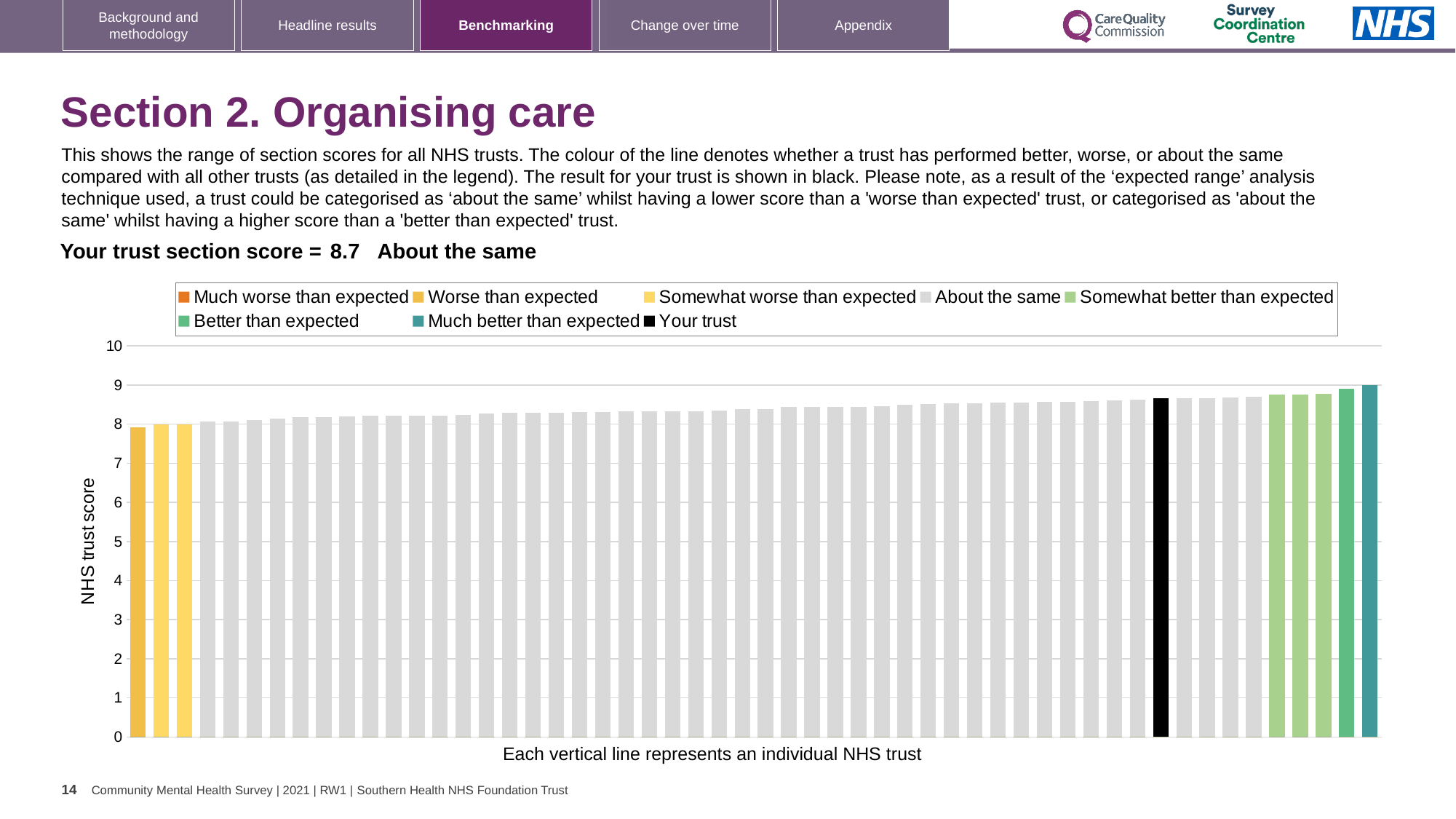
Is the value of the tallest bar greater or less than 10? less Which legend category does the tallest bar on the chart belong to? Much better than expected What is the section score for your trust shown on the slide? 8.7 How many entries does the chart legend list? 8 What is the label on the vertical axis of the chart? NHS trust score Do the bar values rise or fall from left to right along the x axis? rise Is the value of the black 'Your trust' bar greater or less than 8? greater What colour is the bar representing your trust? black Is the value of the tallest bar greater or less than 8? greater Which category is your trust's section score placed in, according to the slide? About the same What kind of chart is shown on the slide? bar chart